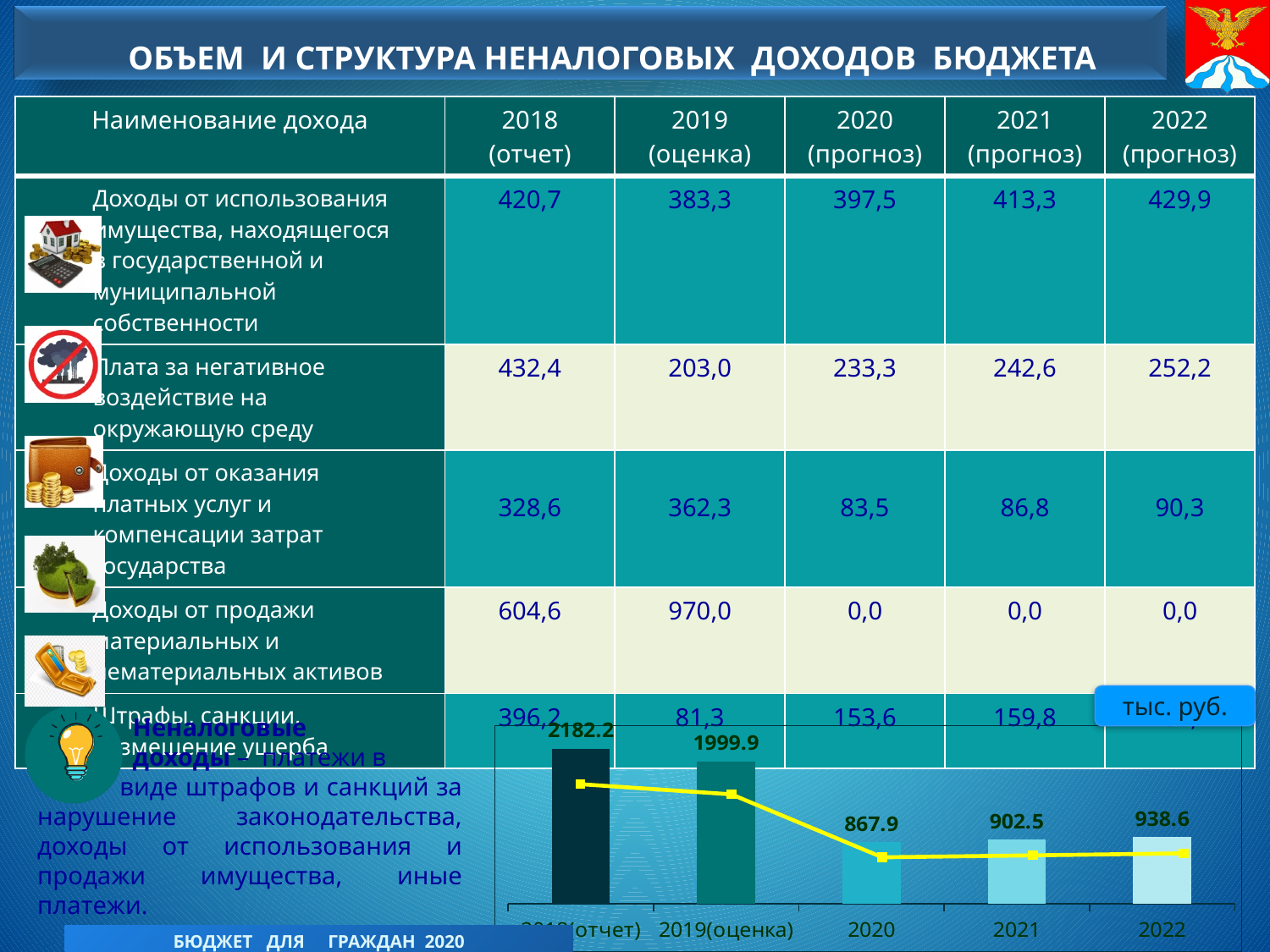
How many categories (years) are shown in the chart at the bottom of the slide? 5 In the chart at the bottom of the slide, what is the value for 2019(оценка)? 1999.9 In the chart at the bottom of the slide, what is the difference between the values for 2022 and 2021? 36.1 In the chart at the bottom of the slide, what is the value for 2020? 867.9 In the chart at the bottom of the slide, what is the value for 2022? 938.6 In the chart at the bottom of the slide, which year has the highest value? 2018(отчет) In the chart at the bottom of the slide, what is the difference between the values for 2018(отчет) and 2019(оценка)? 182.3 In the chart at the bottom of the slide, which is larger, the value for 2021 or the value for 2020? 2021 In the chart at the bottom of the slide, which year has the lowest value? 2020 In the chart at the bottom of the slide, what unit is indicated in the label at the top right of the chart? тыс. руб. In the chart at the bottom of the slide, what is the value for 2018(отчет)? 2182.2 What kind of chart is shown at the bottom of the slide? bar chart with a line